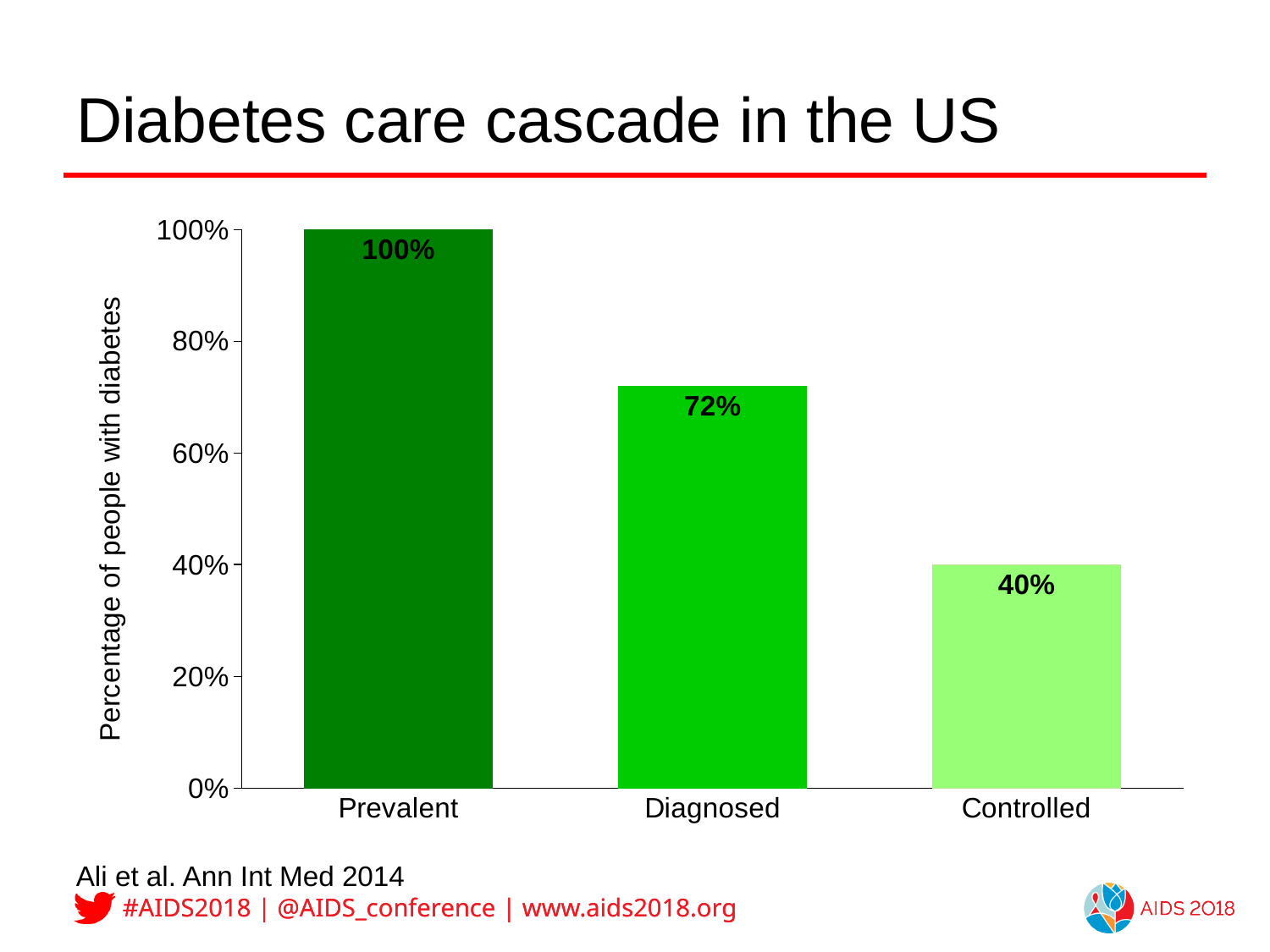
What is the value for Controlled? 40% What is the value for Diagnosed? 72% What is the value for Prevalent? 100% What kind of chart is shown on the slide? bar chart Is the value for Diagnosed greater or less than 60%? greater Which is larger, the value for Diagnosed or the value for Controlled? Diagnosed Which category has the highest value? Prevalent What is the difference between the values for Prevalent and Diagnosed? 28% Do the values rise or fall from left to right along the x axis? fall What is the difference between the values for Diagnosed and Controlled? 32% How many categories are shown on the x axis? 3 Which category has the lowest value? Controlled